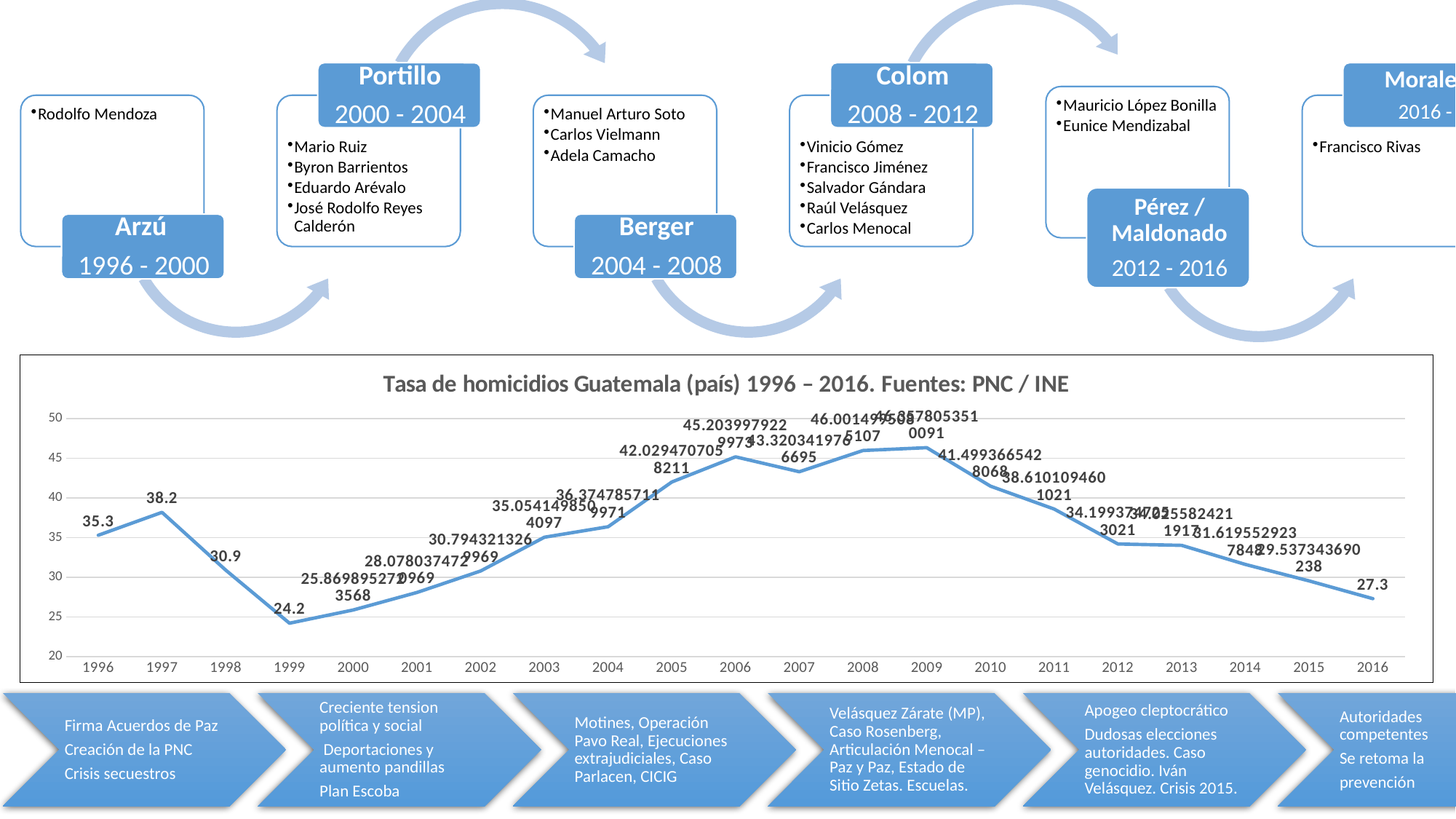
What is the homicide rate value shown for 2016? 27.3 What is the title of the chart? Tasa de homicidios Guatemala (país) 1996 – 2016. Fuentes: PNC / INE What is the homicide rate value shown for 1997? 38.2 What is the homicide rate value shown for 1996? 35.3 Which year has the lowest homicide rate in the chart? 1999 How many years (data points) are plotted on the x axis? 21 Is the value for 2010 greater or less than 40? greater What is the difference between the values for 1996 and 2016? 8.0 Is the value for 2014 greater or less than 35? less What is the difference between the values for 1997 and 1996? 2.9 What is the homicide rate value shown for 1999? 24.2 What type of chart is shown on the slide? Line chart